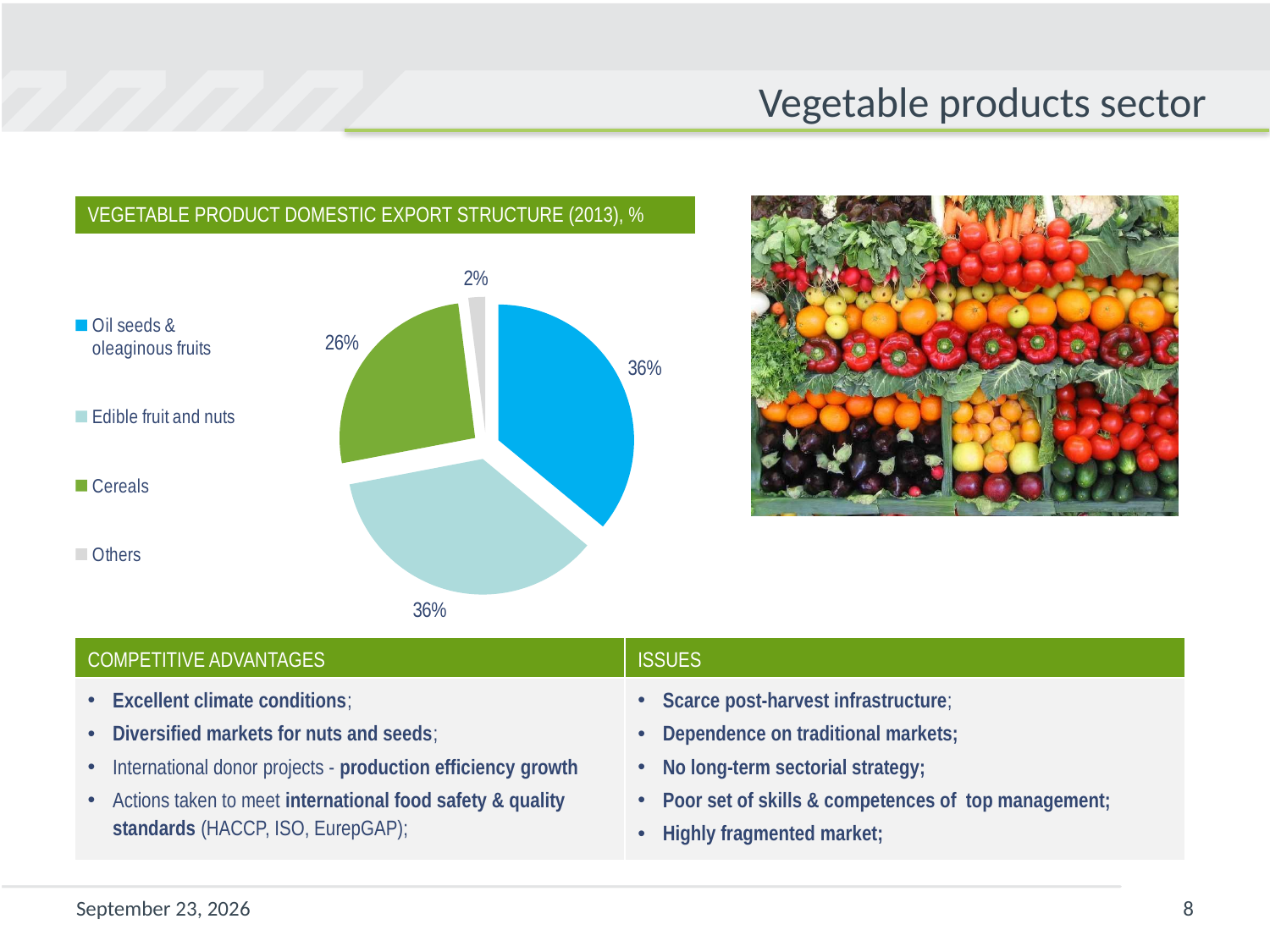
Which is larger in the pie chart: Cereals or Others? Cereals What kind of chart is shown on the slide? Pie chart What is the difference in percentage points between the Edible fruit and nuts share and the Cereals share? 10 percentage points What share of the vegetable product domestic export structure (2013) is Edible fruit and nuts? 36% Which category has the smallest share in the pie chart? Others What is the title of the pie chart? VEGETABLE PRODUCT DOMESTIC EXPORT STRUCTURE (2013), % How many categories does the pie chart show? 4 What share of the vegetable product domestic export structure (2013) is Oil seeds & oleaginous fruits? 36% What share of the vegetable product domestic export structure (2013) is Others? 2% Which is larger in the pie chart: Oil seeds & oleaginous fruits or Cereals? Oil seeds & oleaginous fruits What is the difference in percentage points between the Cereals share and the Others share? 24 percentage points What share of the vegetable product domestic export structure (2013) is Cereals? 26%